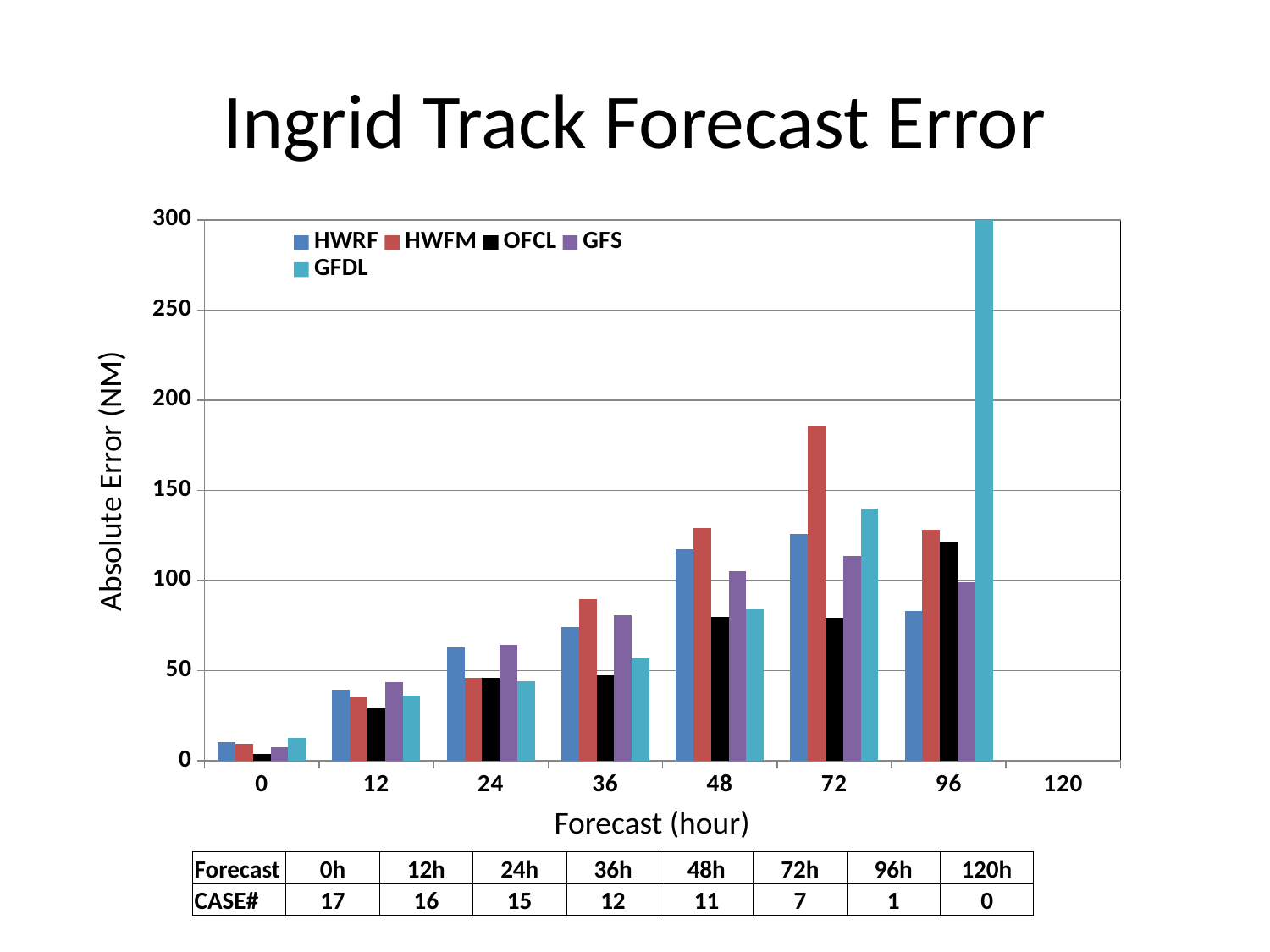
At forecast hour 96, which series has the highest absolute error? GFDL At forecast hour 72, which series has the lowest absolute error? OFCL At forecast hour 48, which is larger, the HWRF value or the OFCL value? HWRF How many series does the chart legend list? 5 At forecast hour 72, which series has the highest absolute error? HWFM Is the HWFM value at forecast hour 72 greater or less than 150? greater Is the OFCL value at forecast hour 12 greater or less than 50? less What is the title of the y axis? Absolute Error (NM) How many forecast hour categories are shown on the x axis? 8 Is the GFDL value at forecast hour 96 greater or less than 250? greater What kind of chart is shown on the slide? bar chart Does the HWFM absolute error rise or fall from forecast hour 0 to forecast hour 72? rise